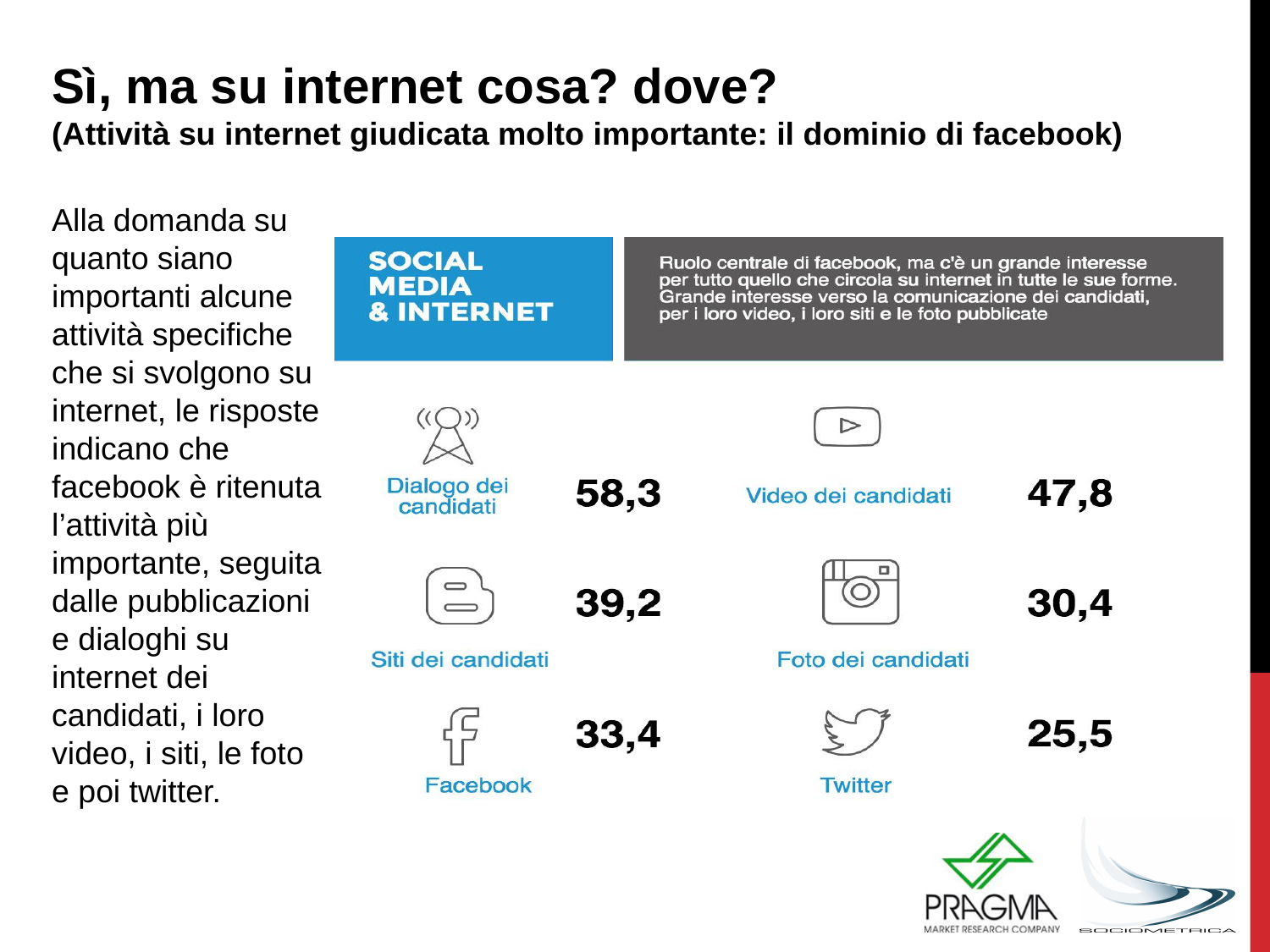
Which item has the lowest value in the infographic? Twitter Which has a larger value, Facebook or Foto dei candidati? Facebook What is the value shown for Twitter? 25,5 How many items with values are shown in the infographic? 6 What is the difference between the values for Facebook and Twitter? 7,9 Which item has the highest value in the infographic? Dialogo dei candidati What is the value shown for Dialogo dei candidati? 58,3 What is the difference between the values for Dialogo dei candidati and Video dei candidati? 10,5 What is the value shown for Foto dei candidati? 30,4 What is the heading in the blue box at the top left of the infographic? SOCIAL MEDIA & INTERNET What is the value shown for Siti dei candidati? 39,2 What is the value shown for Video dei candidati? 47,8